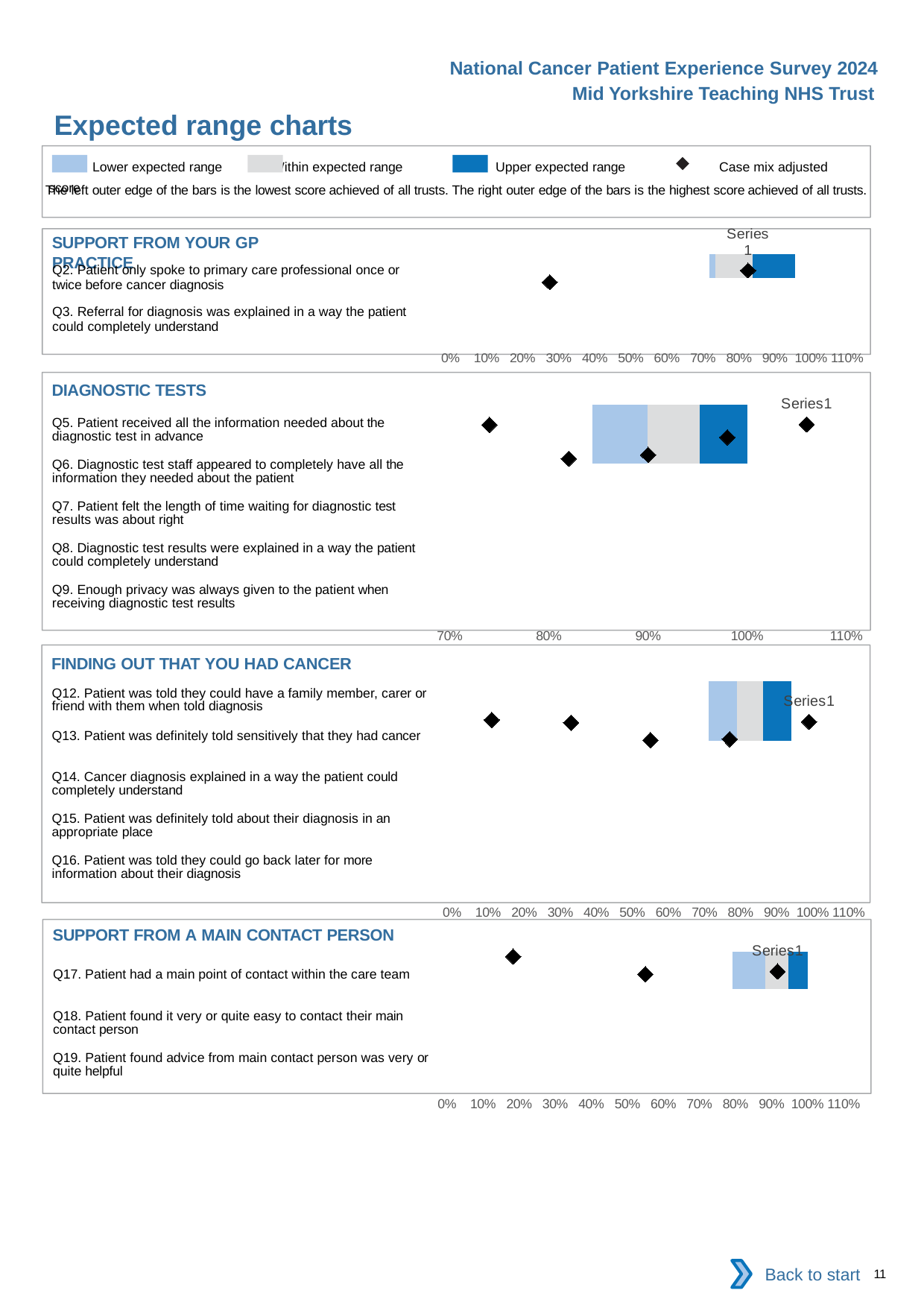
What is the lowest x-axis tick shown on the 'DIAGNOSTIC TESTS' chart? 70% How many questions are listed in the 'FINDING OUT THAT YOU HAD CANCER' chart? 5 How many questions are listed in the 'SUPPORT FROM YOUR GP PRACTICE' chart? 2 What kind of chart is used in the 'DIAGNOSTIC TESTS' section? bar chart What is the lowest x-axis tick shown on the 'FINDING OUT THAT YOU HAD CANCER' chart? 0% How many questions are listed in the 'DIAGNOSTIC TESTS' chart? 5 In the legend, which colour represents the 'Upper expected range'? dark blue What is the highest x-axis tick shown on the 'SUPPORT FROM A MAIN CONTACT PERSON' chart? 110% In the legend, what symbol represents the 'Case mix adjusted score'? black diamond How many entries does the legend at the top of the slide list? 4